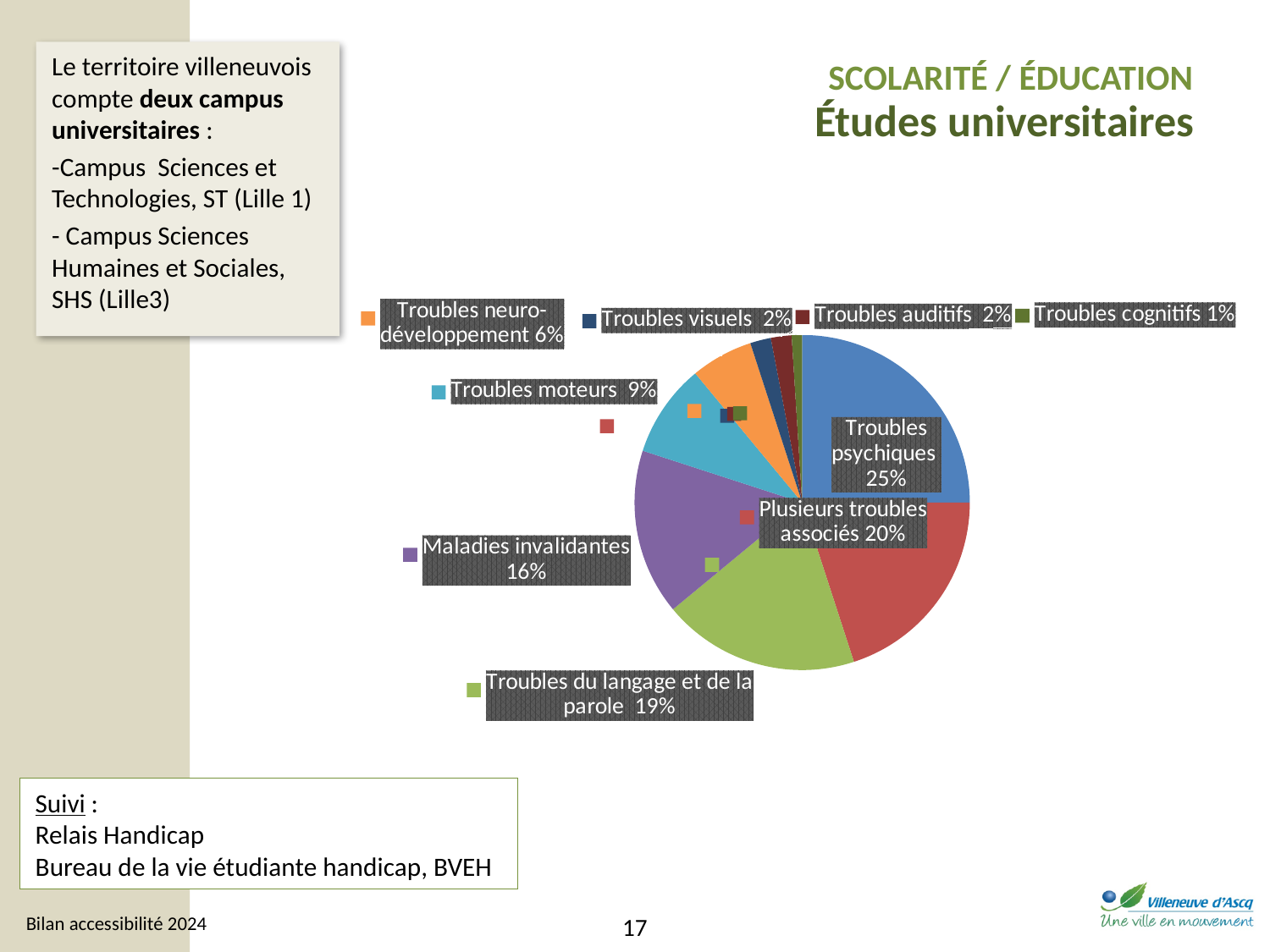
Which category has the largest slice of the pie? Troubles psychiques What share of the pie is labelled "Troubles psychiques"? 25% How many categories (slices) does the pie chart have? 9 What kind of chart is shown on the slide? pie chart What percentage is shown for "Plusieurs troubles associés"? 20% What percentage is shown for "Troubles moteurs"? 9% What percentage is shown for "Maladies invalidantes"? 16% What percentage is shown for "Troubles visuels"? 2% Which is larger, "Troubles moteurs" or "Troubles neuro-développement"? Troubles moteurs Which category has the smallest slice of the pie? Troubles cognitifs What is the difference in percentage points between "Troubles psychiques" and "Maladies invalidantes"? 9 What percentage is shown for "Troubles du langage et de la parole"? 19%